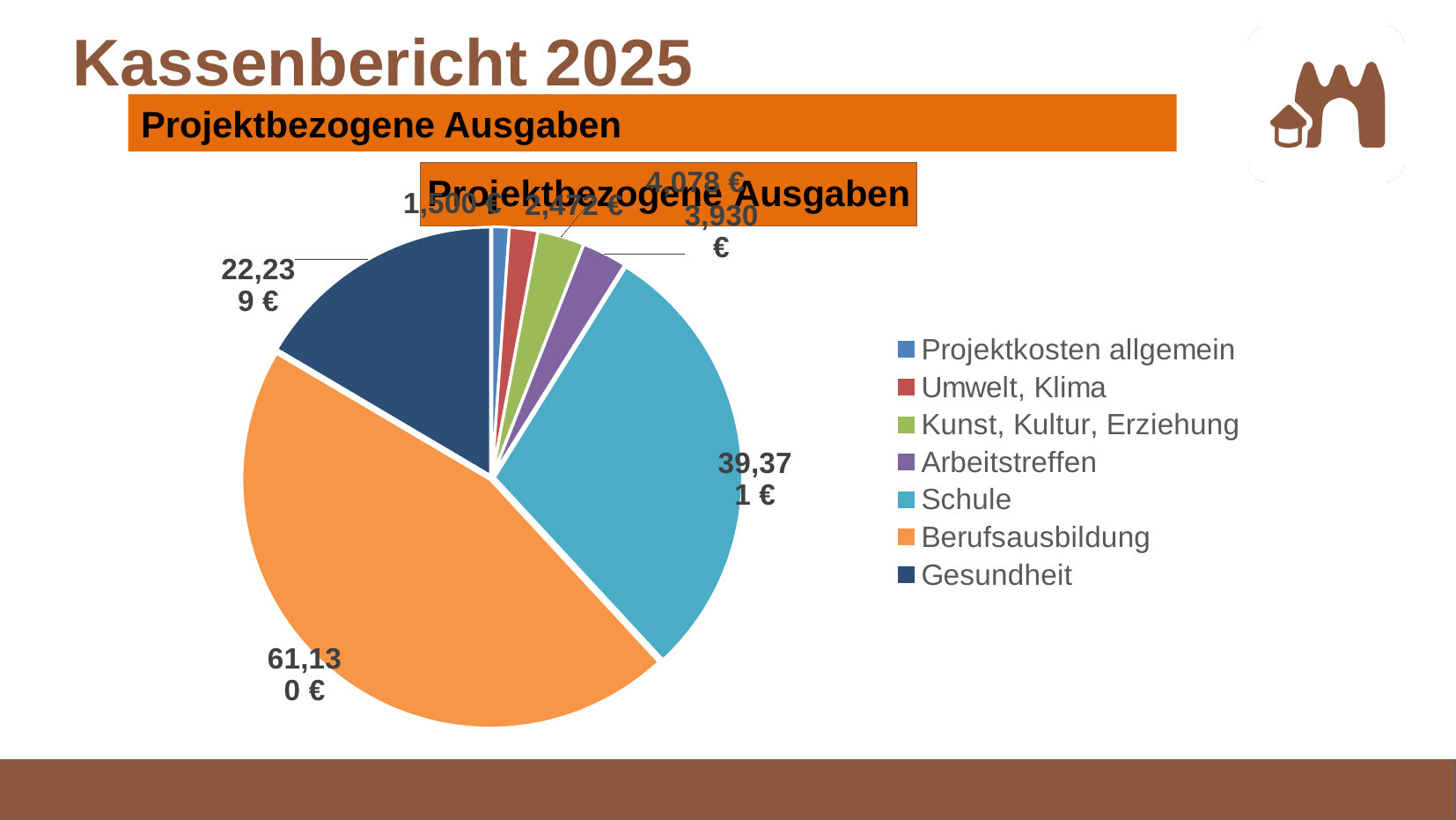
What is the value for Berufsausbildung in the pie chart? 61,130 € What type of chart is shown on the slide? pie chart How many categories does the pie chart show? 7 Which category is shown in orange in the pie chart? Berufsausbildung What is the value for Gesundheit in the pie chart? 22,239 € What is the value for Schule in the pie chart? 39,371 € What is the title of the pie chart? Projektbezogene Ausgaben Which is larger, the value for Schule or the value for Gesundheit? Schule What is the value for Arbeitstreffen in the pie chart? 3,930 € Which category has the largest slice of the pie chart? Berufsausbildung Which category has the smallest slice of the pie chart? Projektkosten allgemein What is the difference between the values for Berufsausbildung and Schule? 21,759 €